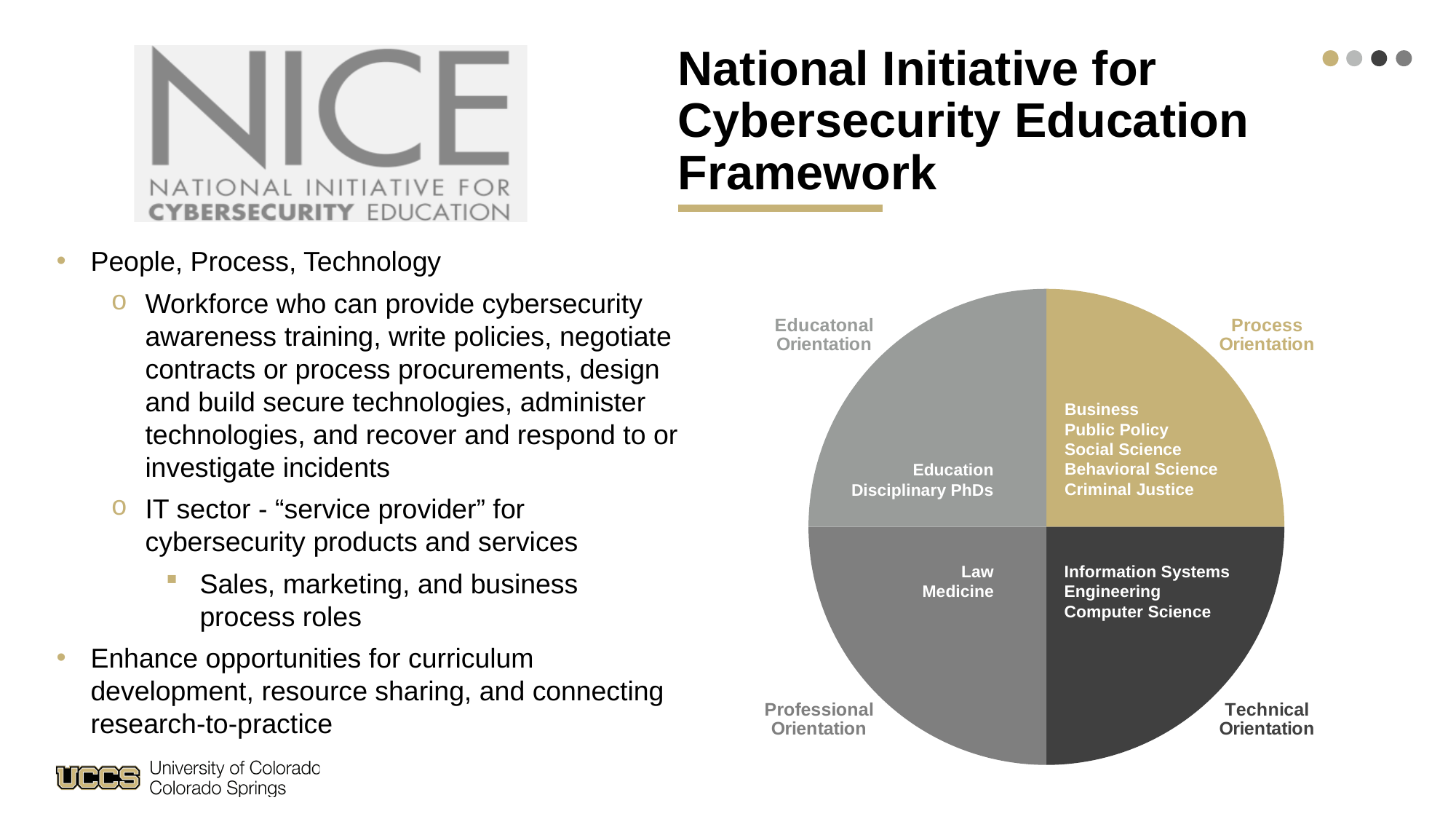
Which slice of the pie chart contains Medicine? Professional Orientation Which slice of the pie chart contains Criminal Justice? Process Orientation How many slices does the pie chart have? 4 Which slice of the pie chart is the darkest in colour? Technical Orientation Which disciplines are listed in the Educational Orientation slice of the pie chart? Education, Disciplinary PhDs Which slice of the pie chart is coloured gold? Process Orientation Which disciplines are listed in the Process Orientation slice of the pie chart? Business, Public Policy, Social Science, Behavioral Science, Criminal Justice Which disciplines are listed in the Professional Orientation slice of the pie chart? Law, Medicine What kind of chart is shown on the slide? pie chart Which disciplines are listed in the Technical Orientation slice of the pie chart? Information Systems, Engineering, Computer Science